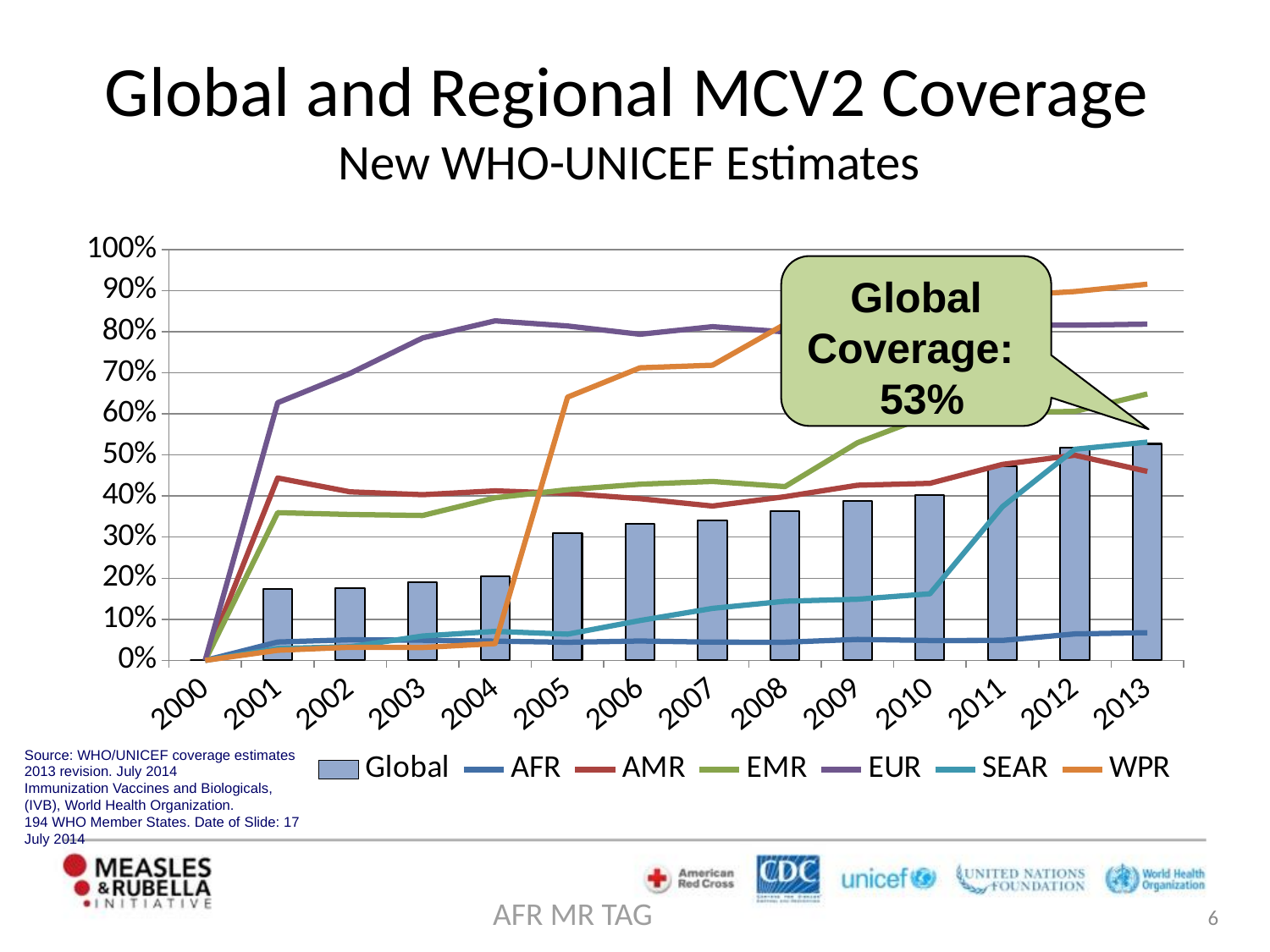
How many years are shown along the x axis? 14 What is the global MCV2 coverage value shown in the callout for 2013? 53% In 2013, which is larger, the EUR value or the AMR value? EUR Which series is drawn as bars rather than a line? Global Is the value for AFR in 2013 greater or less than 10%? less How many series does the legend list? 7 Which region has the highest coverage in 2013? WPR Is the value for WPR in 2013 greater or less than 80%? greater Which region has the lowest coverage in 2013? AFR Is the Global bar for 2001 greater or less than 20%? less What kind of chart is this? Combined bar and line chart Do the Global bars rise or fall from 2001 to 2013? rise